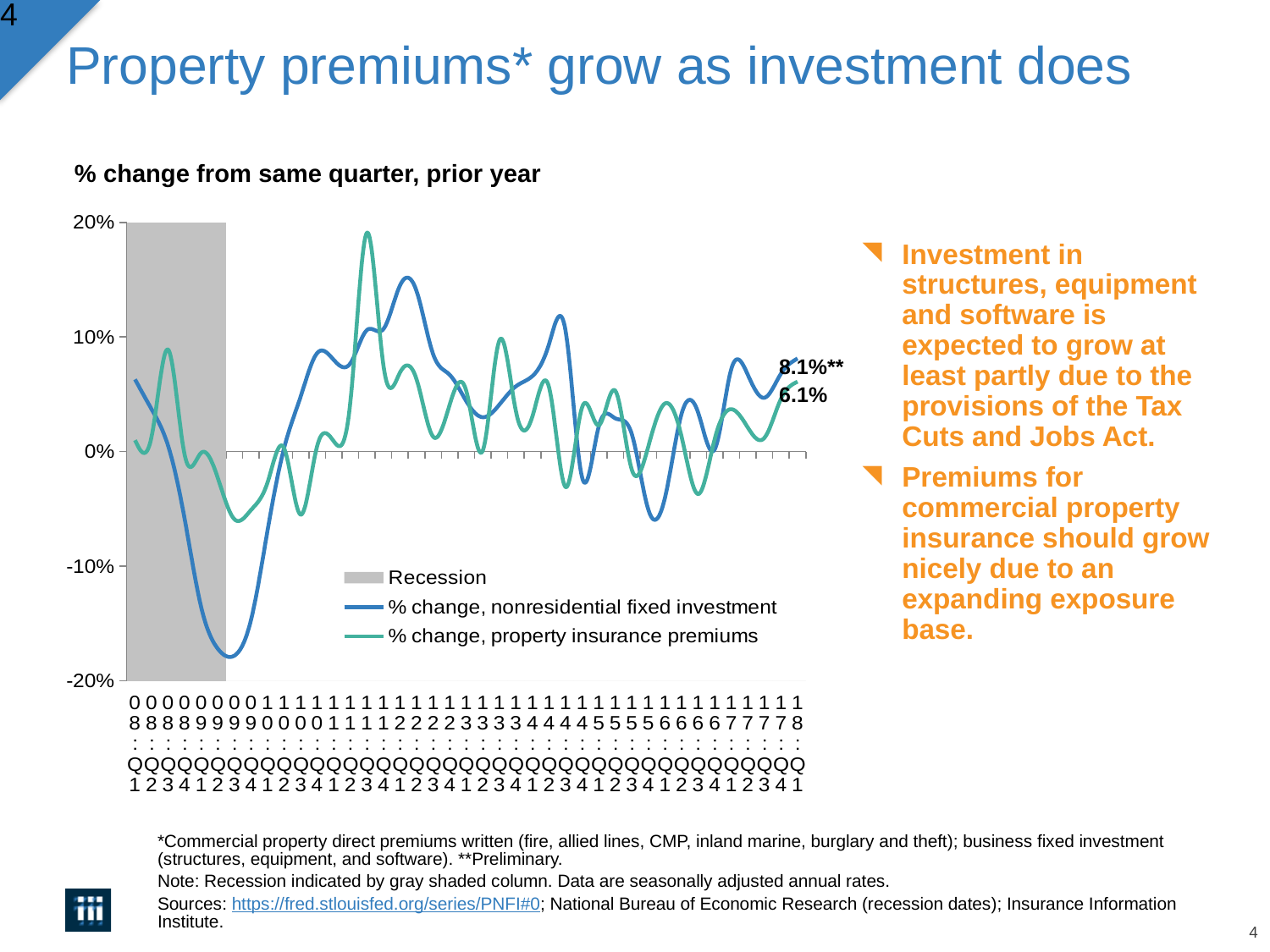
What is the subtitle printed above the chart? % change from same quarter, prior year Is the lowest value of % change in nonresidential fixed investment during the recession period greater or less than -10%? less How many entries does the legend list? 3 What is the labeled value for % change in nonresidential fixed investment at the end of the series (18:Q1)? 8.1% Which series reaches the higher peak on the chart? % change, property insurance premiums Does the % change in nonresidential fixed investment rise or fall from 08:Q1 to 09:Q2? fall At the end of the series, which is larger: the % change in nonresidential fixed investment or the % change in property insurance premiums? % change, nonresidential fixed investment Which series reaches the lowest point on the chart? % change, nonresidential fixed investment What is the labeled value for % change in property insurance premiums at the end of the series (18:Q1)? 6.1% Is the peak value of % change in property insurance premiums around 2010 greater or less than 10%? greater What kind of chart is shown on the slide? Line chart What is the difference between the two labeled end values, 8.1% and 6.1%? 2.0 percentage points